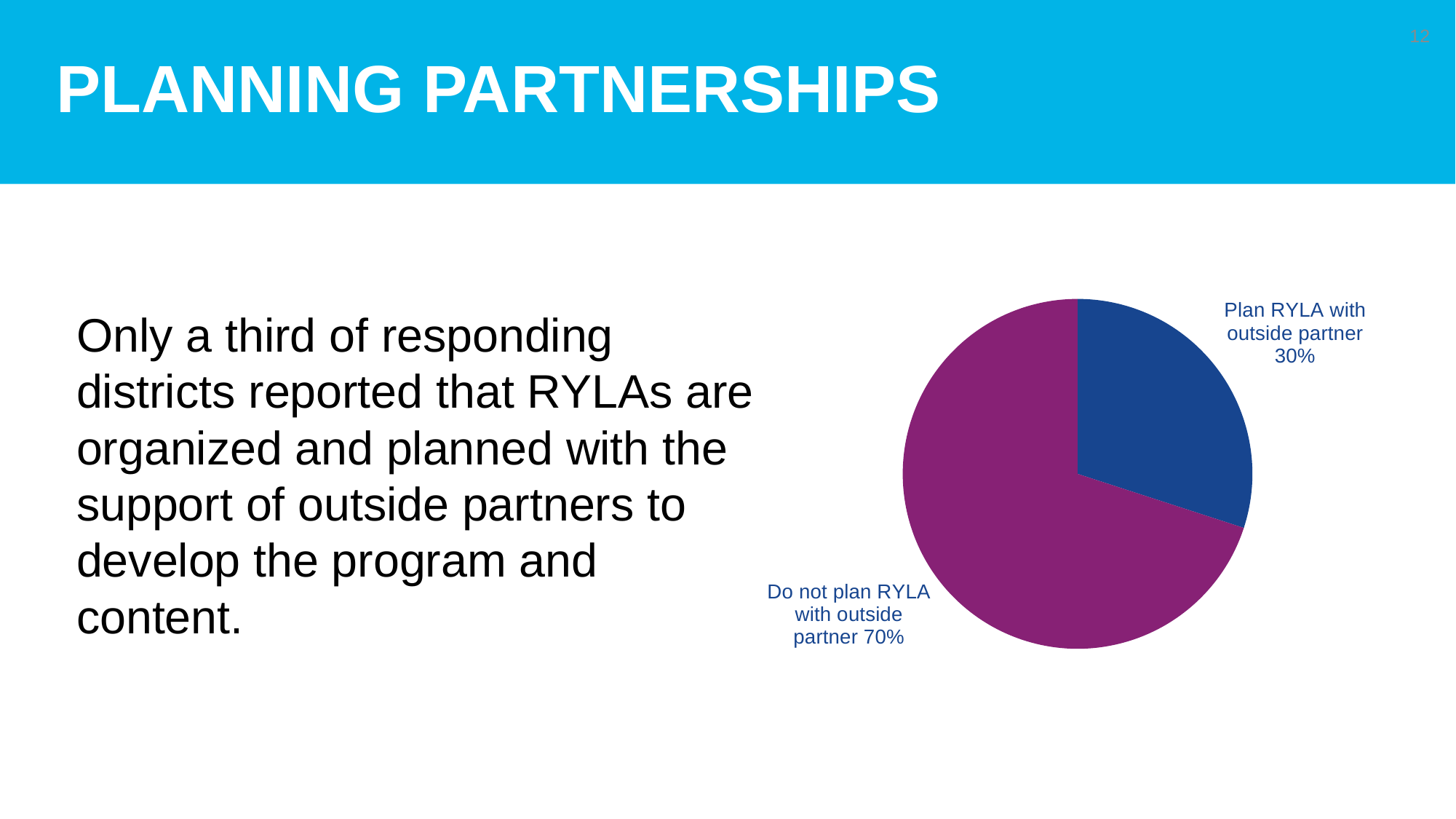
What kind of chart is shown on the slide? Pie chart What is the total of the two slices shown in the pie chart? 100% What share of districts do not plan RYLA with an outside partner? 70% What share of districts plan RYLA with an outside partner? 30% What is the difference in percentage points between districts that do not plan RYLA with an outside partner and those that do? 40 Which category has the largest slice of the pie? Do not plan RYLA with outside partner Which category has the smallest slice of the pie? Plan RYLA with outside partner What colour is the slice for districts that plan RYLA with an outside partner? Blue What colour is the slice for districts that do not plan RYLA with an outside partner? Purple Which is larger: the share that plans RYLA with an outside partner or the share that does not? Do not plan RYLA with outside partner How many slices does the pie chart have? 2